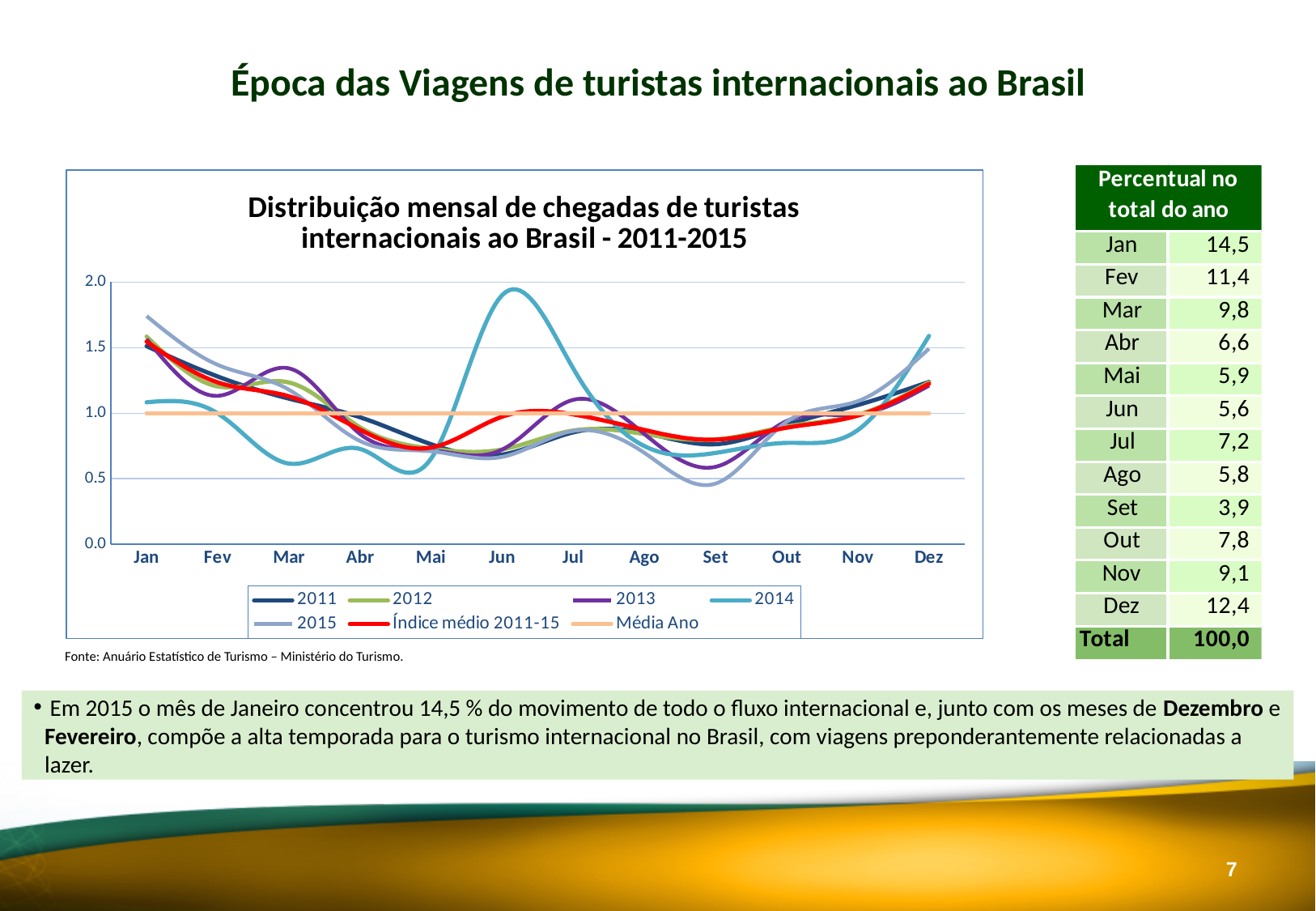
In which month does the 2014 series reach its highest value? Jun How many months are plotted along the x axis of the chart? 12 What is the title of the chart? Distribuição mensal de chegadas de turistas internacionais ao Brasil - 2011-2015 In which month does the 2015 series reach its lowest value? Set Is the value for 2014 in Jun greater or less than 1.5? greater In Jan, which series has the larger value, 2015 or 2014? 2015 What kind of chart is shown on the slide? line chart Does the 2014 series rise or fall from Jan to Mar? fall What is the value of the 'Média Ano' line across all months? 1.0 Is the value for 2015 in Set greater or less than 0.5? less How many series does the chart legend list? 7 Is the value for 2013 in Mar greater or less than 1.0? greater